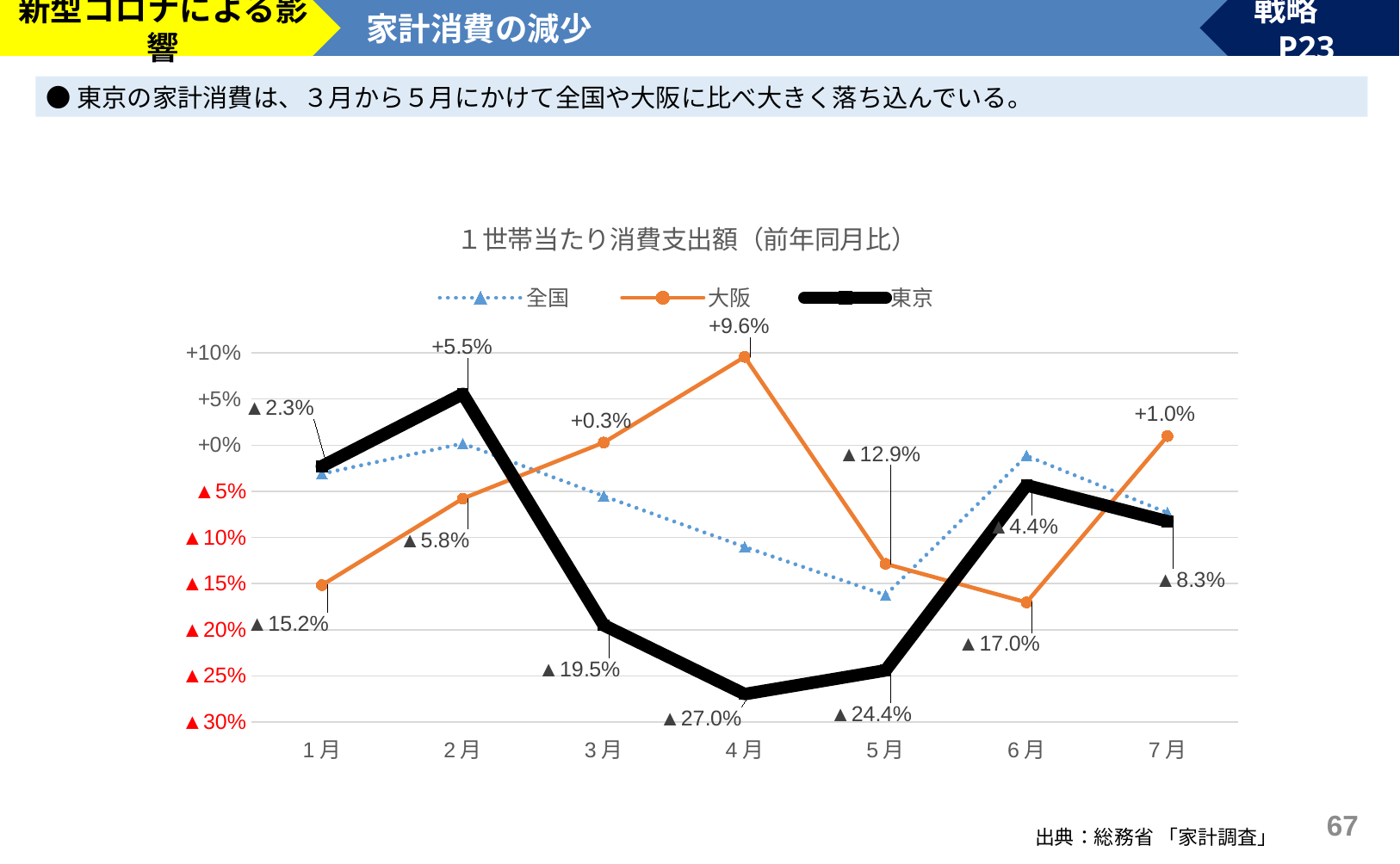
What kind of chart is shown on the slide? Line chart In which month does the 大阪 series reach its highest value? 4月 In which month does the 東京 series reach its lowest value? 4月 In 4月, which is higher: 東京 or 大阪? 大阪 What is the value for 東京 in 2月? +5.5% What is the value for 大阪 in 4月? +9.6% What is the value for 大阪 in 7月? +1.0% How many series does the legend list? 3 What is the value for 東京 in 4月? ▲27.0% How many months are plotted on the x axis? 7 By how many percentage points does the 東京 value change from 3月 (▲19.5%) to 4月 (▲27.0%)? 7.5 percentage points Does the 東京 series rise or fall from 2月 to 4月? Fall